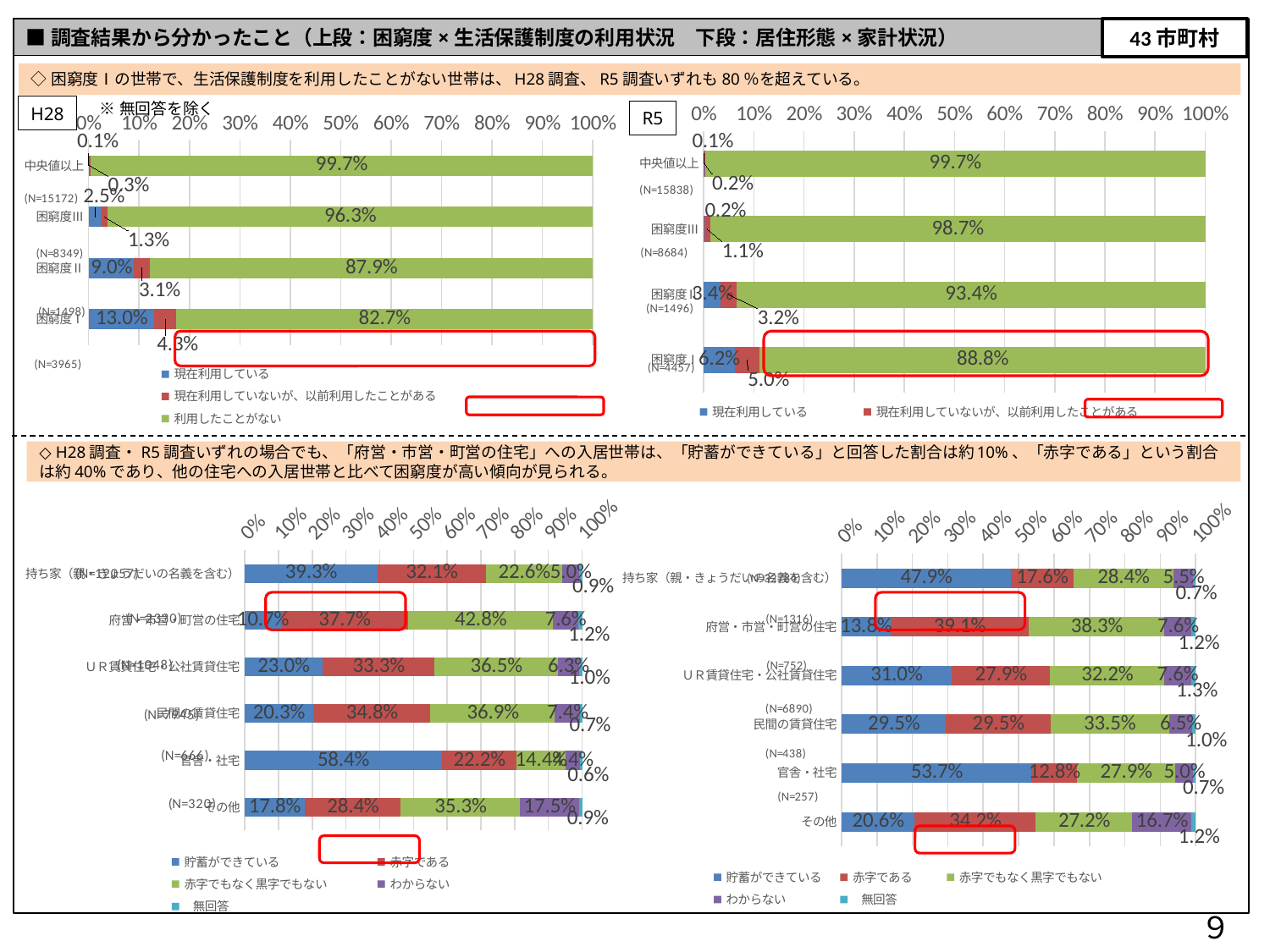
What type of chart is the bottom-left H28 chart (居住形態 × 家計状況)? Stacked bar chart In the top-left H28 chart (困窮度 × 生活保護制度の利用状況), what percentage of 困窮度Ⅰ households are 利用したことがない? 82.7% In the bottom-left H28 chart (居住形態 × 家計状況), what percentage of 府営・市営・町営の住宅 households answered 赤字である? 37.7% In the top-right R5 chart (困窮度 × 生活保護制度の利用状況), what percentage of 困窮度Ⅰ households are 現在利用している? 6.2% In the top-left H28 chart, which category has the highest 現在利用している percentage? 困窮度Ⅰ In the top-left H28 chart, how many categories are plotted? 4 In the bottom-right R5 chart, what is the difference between the 赤字である percentages for その他 and 持ち家? 16.6% In the bottom-right R5 chart (居住形態 × 家計状況), what percentage of 官舎・社宅 households answered 貯蓄ができている? 53.7% In the bottom-right R5 chart, which housing type has the lowest 貯蓄ができている percentage? 府営・市営・町営の住宅 In the bottom-left H28 chart, which is larger: the 貯蓄ができている percentage for 官舎・社宅 or for 持ち家? 官舎・社宅 In the top-right R5 chart, what is the difference between the 利用したことがない percentages for 中央値以上 and 困窮度Ⅰ? 10.9% How many series does the legend of the bottom-right R5 chart list? 5